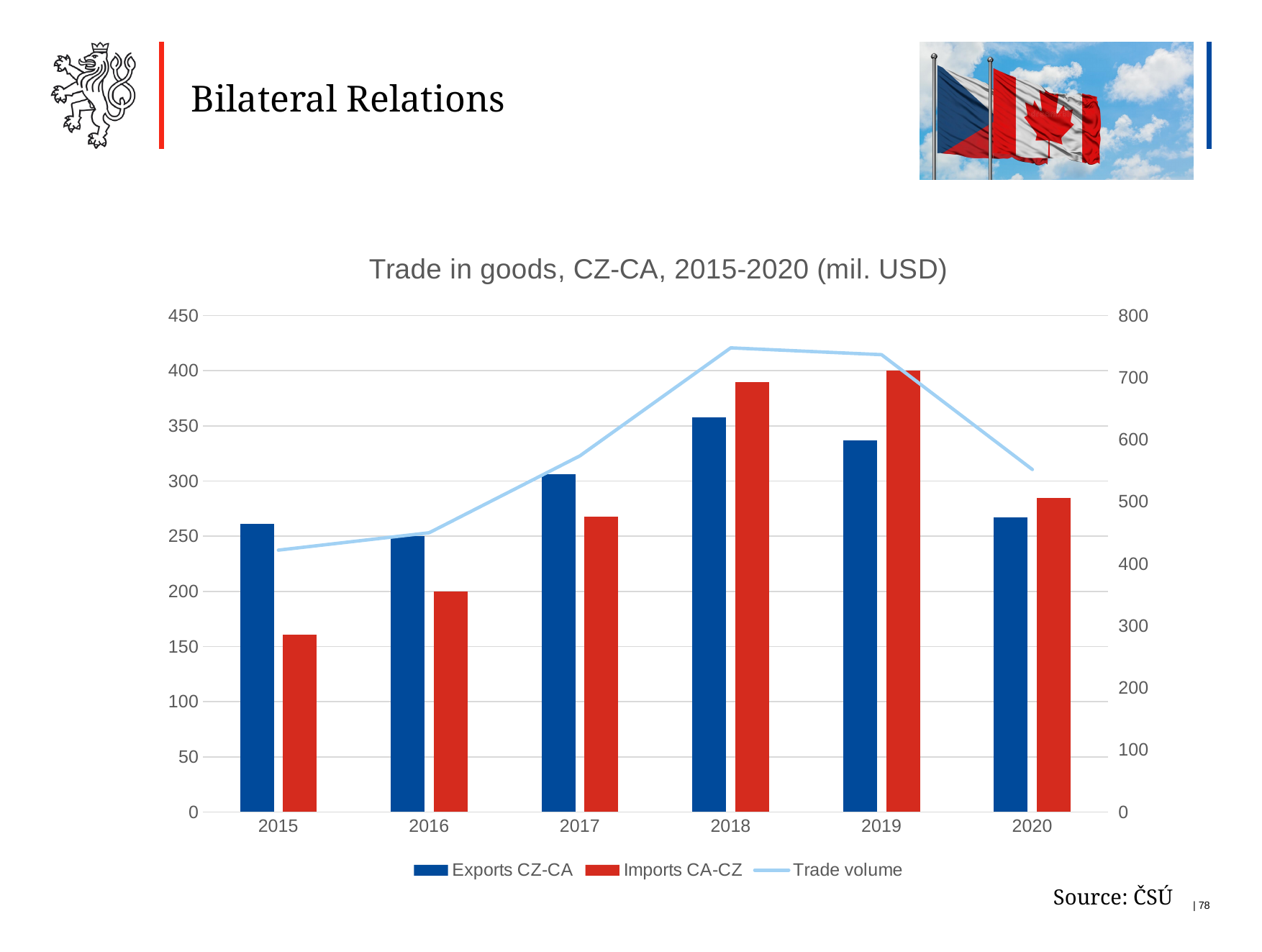
In 2015, which is larger: Exports CZ-CA or Imports CA-CZ? Exports CZ-CA What is the title of the chart? Trade in goods, CZ-CA, 2015-2020 (mil. USD) How many years are shown on the x axis? 6 In which year are Exports CZ-CA highest? 2018 In which year are Imports CA-CZ highest? 2019 In 2019, which is larger: Exports CZ-CA or Imports CA-CZ? Imports CA-CZ Is the value for Imports CA-CZ in 2015 greater or less than 200? less Is the value for Exports CZ-CA in 2018 greater or less than 300? greater What kind of chart is shown on the slide? bar chart with a line Does the Trade volume line rise or fall from 2015 to 2018? rise In which year are Imports CA-CZ lowest? 2015 How many series does the legend list? 3